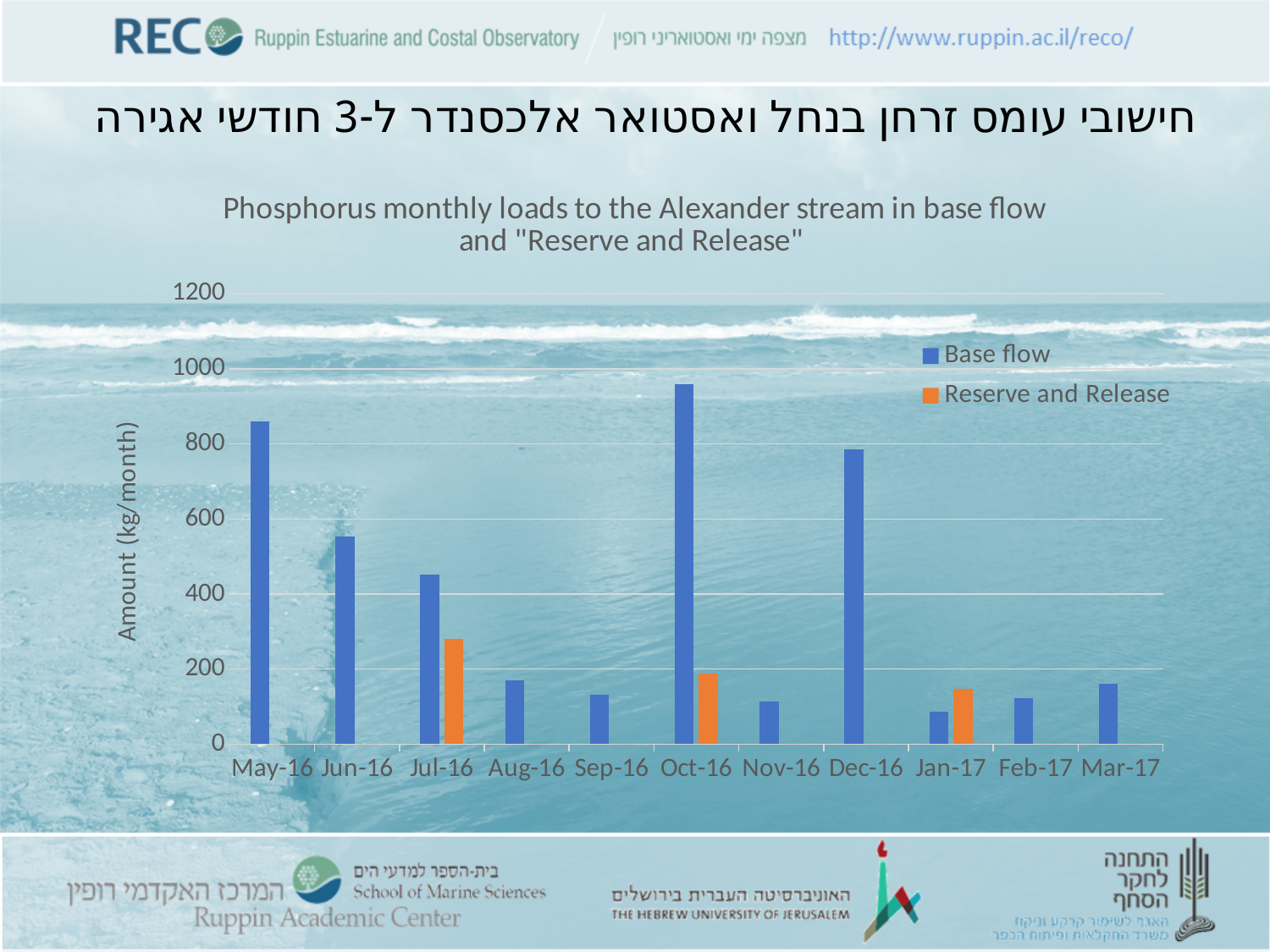
What is the label of the y axis? Amount (kg/month) How many series does the legend list? 2 Is the Base flow value for May-16 greater or less than 800? greater Which is larger, the Base flow value for Jul-16 or the Reserve and Release value for Jul-16? Base flow Which month has the highest Base flow value? Oct-16 Is the Reserve and Release value for Jul-16 greater or less than 200? greater How many months are shown on the x axis? 11 Is the Base flow value for Jun-16 greater or less than 600? less In which months does the Reserve and Release series have a bar? Jul-16, Oct-16, Jan-17 Which month has the lowest Base flow value? Jan-17 What kind of chart is shown on the slide? bar chart